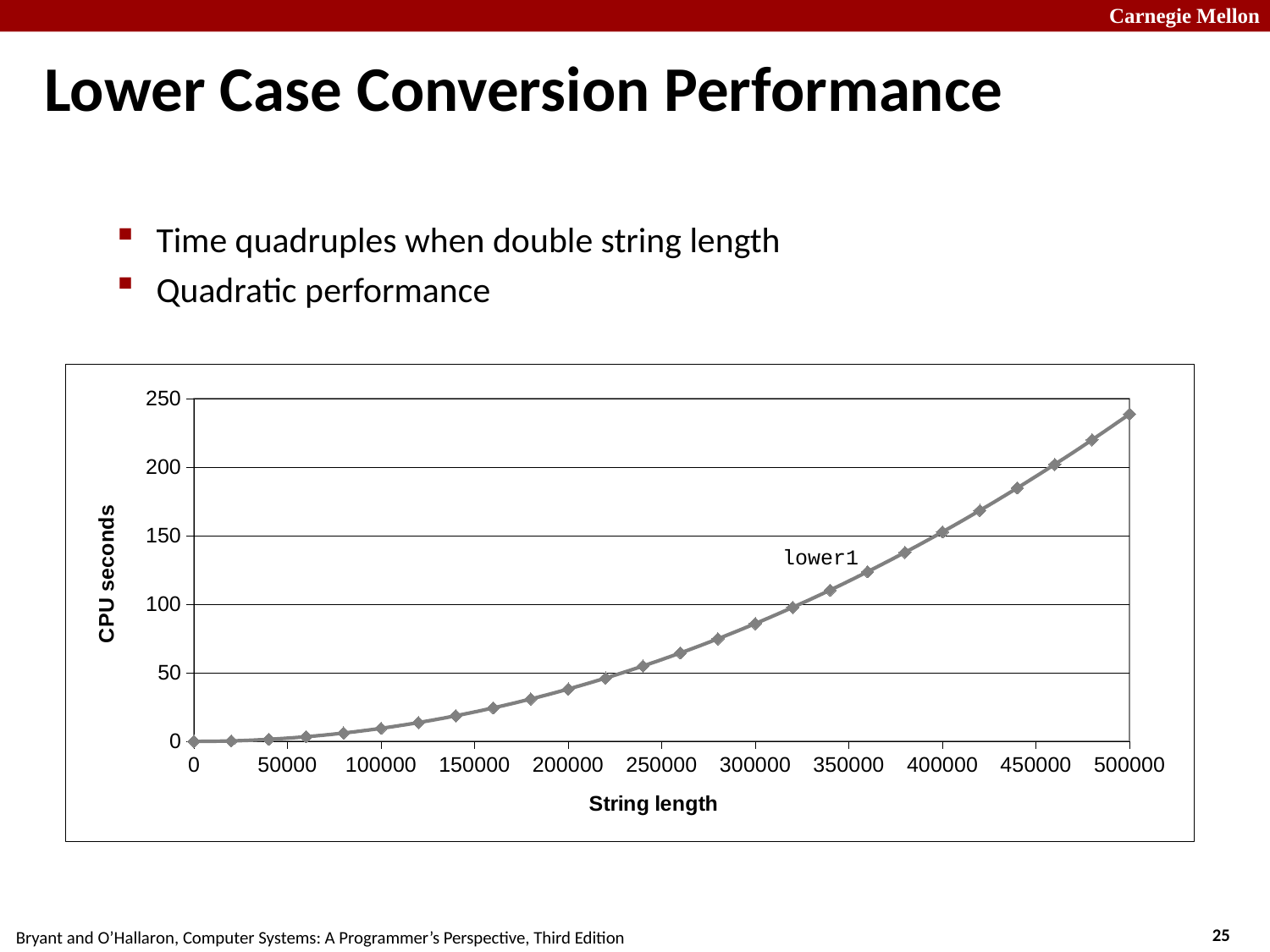
Which has the larger CPU time, string length 200000 or string length 400000? 400000 What is the title of the x axis of the chart? String length What is the name of the series plotted in the chart? lower1 Is the CPU time at string length 400000 greater or less than 100? greater At which string length is the CPU time highest? 500000 At which string length is the CPU time lowest? 0 Is the CPU time at string length 300000 greater or less than 100? less What kind of chart is shown on the slide? line chart Is the CPU time at string length 100000 greater or less than 50? less What is the title of the y axis of the chart? CPU seconds Do the CPU seconds rise or fall as string length increases? rise